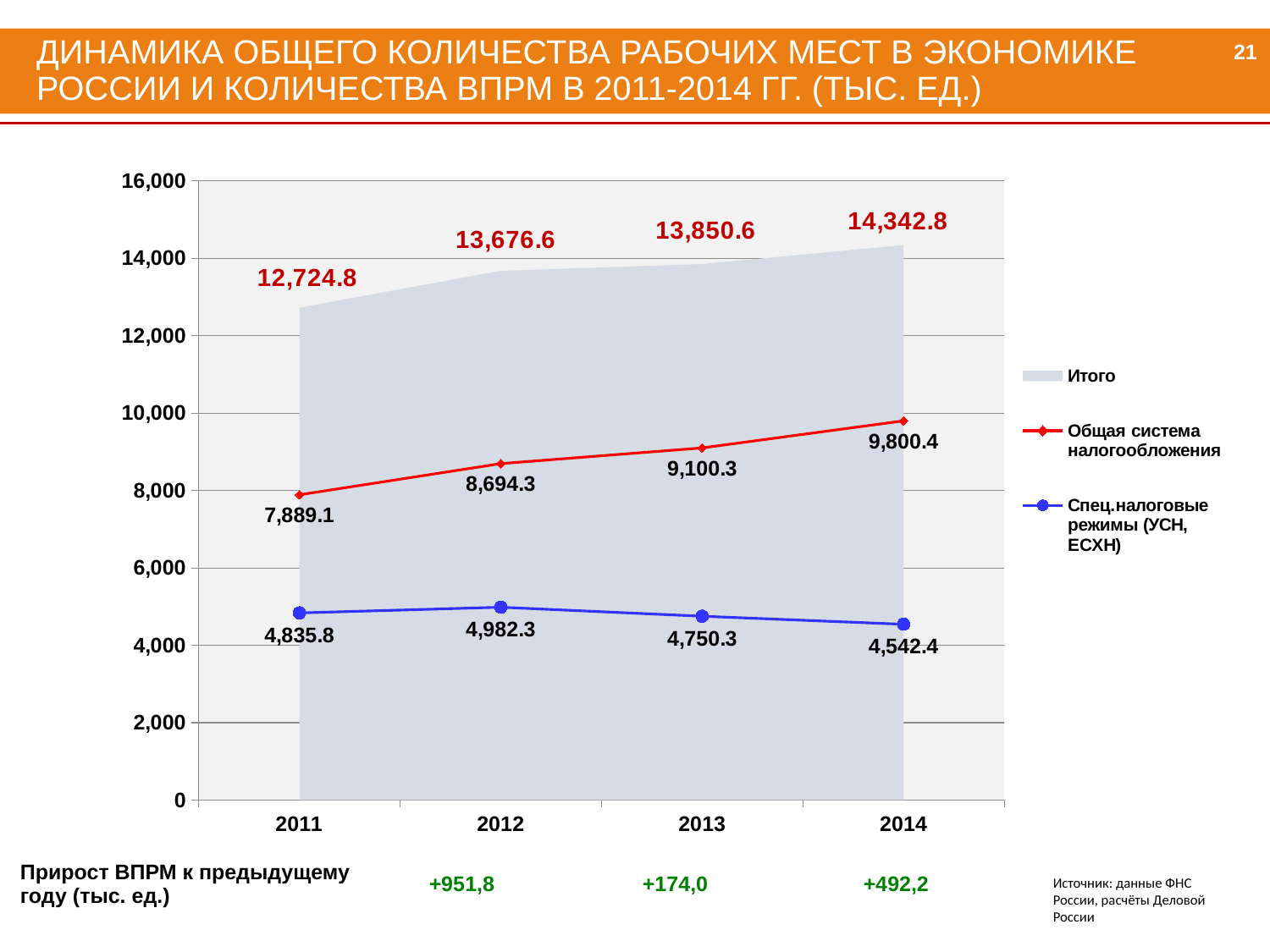
What is the value of Спец.налоговые режимы (УСН, ЕСХН) for 2013? 4,750.3 Do the values of Общая система налогообложения rise or fall from 2011 to 2014? rise What is the value of Общая система налогообложения for 2012? 8,694.3 In which year is the value of Итого lowest? 2011 What is the difference between the Общая система налогообложения values for 2014 and 2011? 1,911.3 What kind of chart is shown on the slide? Combined area and line chart Is the value of Общая система налогообложения for 2013 greater or less than 10,000? less How many series does the legend list? 3 In which year is the value of Спец.налоговые режимы (УСН, ЕСХН) highest? 2012 Which is larger in 2011: the value for Общая система налогообложения or for Спец.налоговые режимы (УСН, ЕСХН)? Общая система налогообложения How many years are shown on the x axis? 4 What is the value of Итого for 2014? 14,342.8